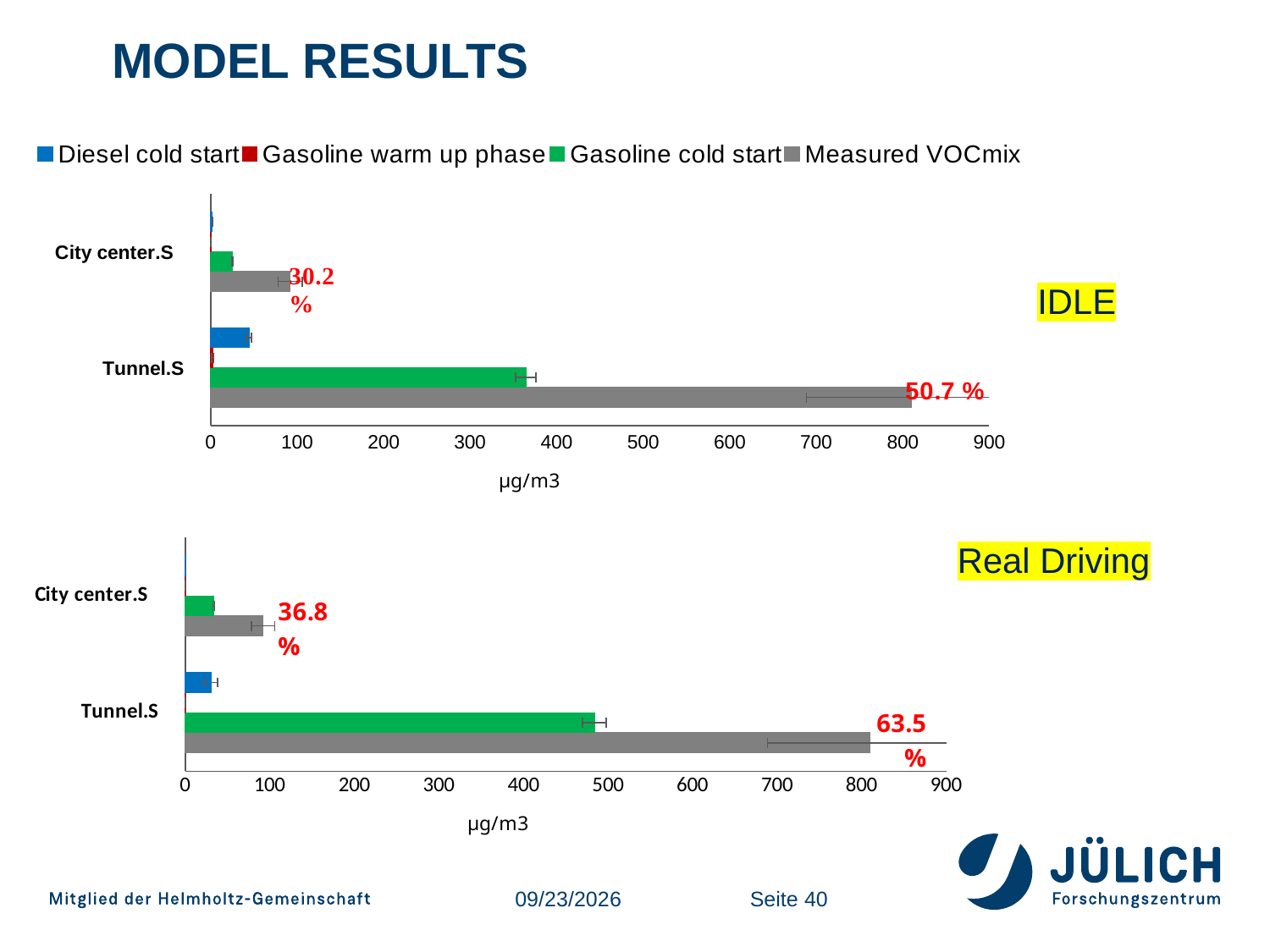
What unit is shown on the x axis of the charts? µg/m3 What percentage is annotated next to the Tunnel.S bars in the Real Driving chart? 63.5 % In the Real Driving chart, is the Diesel cold start value for Tunnel.S greater or less than 100? less How many series does the legend list? 4 What kind of chart is the IDLE chart? bar chart In the IDLE chart, is the Gasoline cold start value for Tunnel.S greater or less than 300? greater In the IDLE chart, is the Measured VOCmix value larger for Tunnel.S or for City center.S? Tunnel.S In the Real Driving chart, is the Measured VOCmix value for Tunnel.S greater or less than 700? greater In the IDLE chart, which series has the highest value for Tunnel.S? Measured VOCmix In the IDLE chart, which series has the lowest value for Tunnel.S? Gasoline warm up phase Is the Gasoline cold start value for Tunnel.S larger in the Real Driving chart or in the IDLE chart? Real Driving How many categories are shown on the Real Driving chart? 2